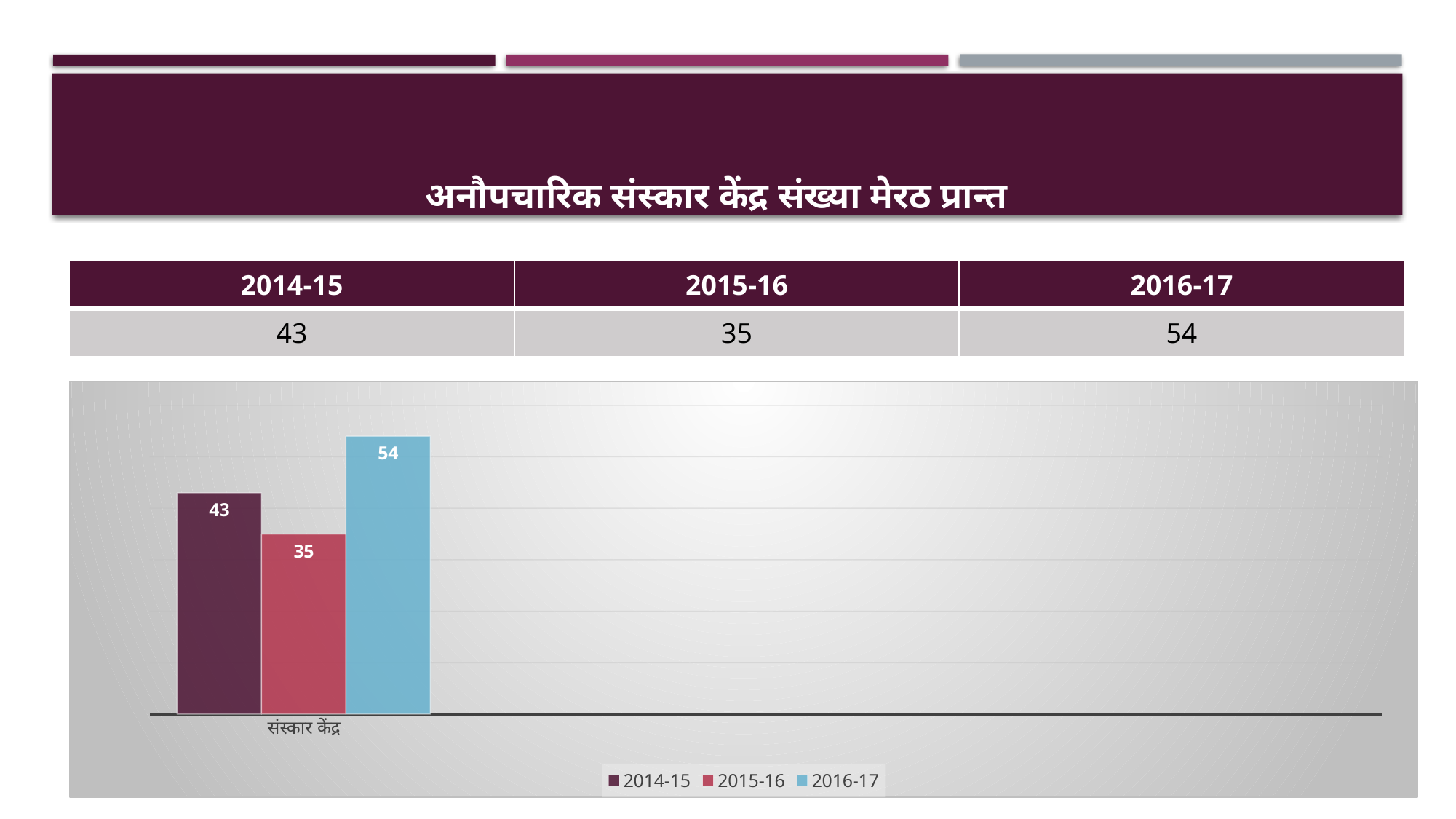
What is the category label on the x axis of the chart? संस्कार केंद्र Which series has the highest value in the chart? 2016-17 Which series has the lowest value in the chart? 2015-16 What kind of chart is shown on the slide? bar chart What is the value for 2014-15 in the chart? 43 How many series does the legend list? 3 Which is larger, the value for 2014-15 or the value for 2016-17? 2016-17 What is the value for 2016-17 in the chart? 54 What is the value for 2015-16 in the chart? 35 What is the difference between the values for 2014-15 and 2015-16? 8 What colour is the bar for 2016-17 in the chart? blue What is the difference between the values for 2016-17 and 2015-16? 19